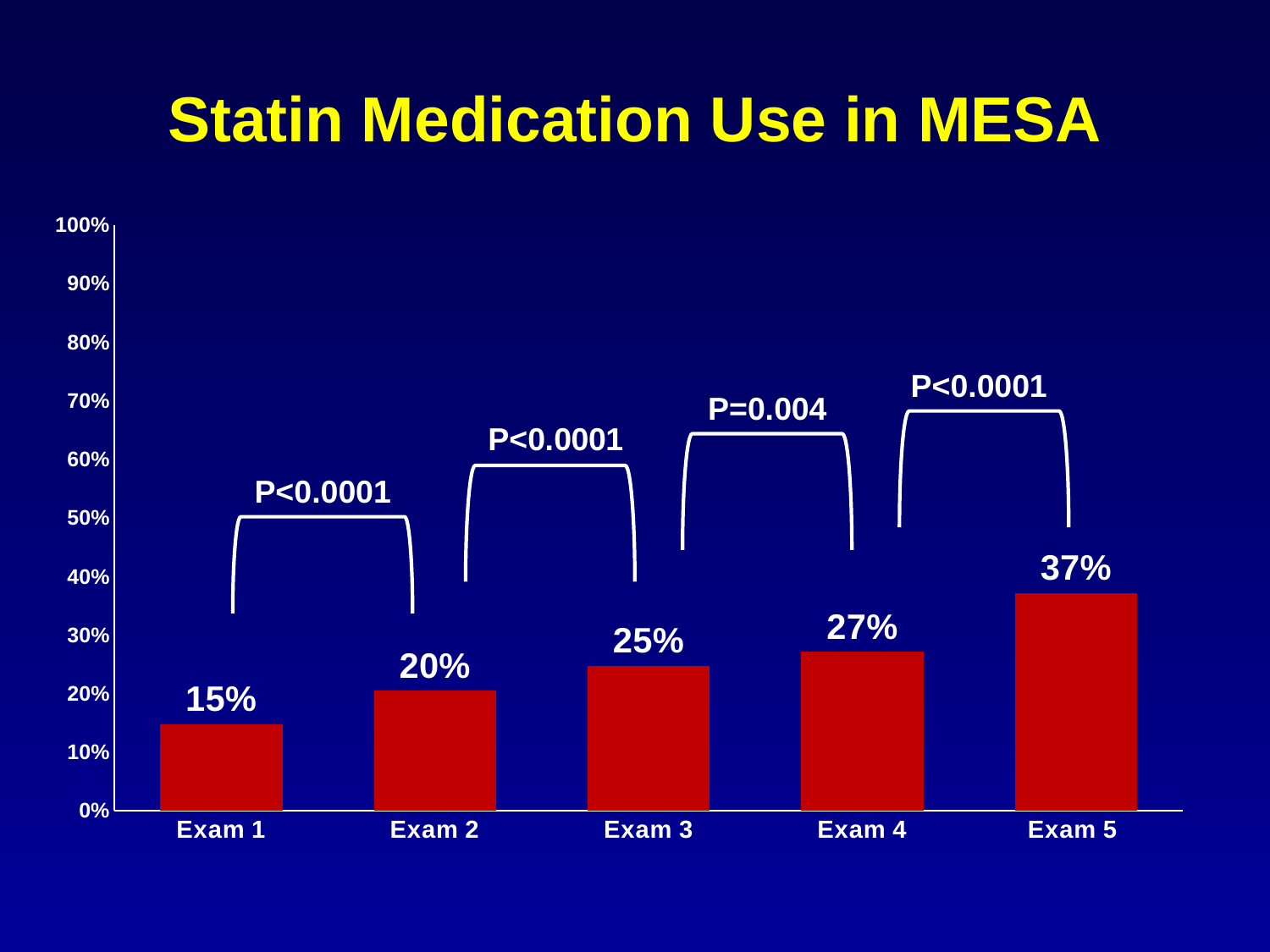
Which exam has the highest statin medication use? Exam 5 Do the values rise or fall from Exam 1 to Exam 5? Rise How many exams are shown on the x axis? 5 Is the value for Exam 5 greater or less than 30%? greater What is the difference between the values for Exam 5 and Exam 4? 10% Which exam has the lowest statin medication use? Exam 1 What is the value shown for Exam 5? 37% What is the statin medication use value for Exam 1? 15% Which is larger, the value for Exam 3 or the value for Exam 4? Exam 4 What is the difference between the values for Exam 2 and Exam 1? 5% What kind of chart is shown on the slide? Bar chart What is the value shown for Exam 3? 25%